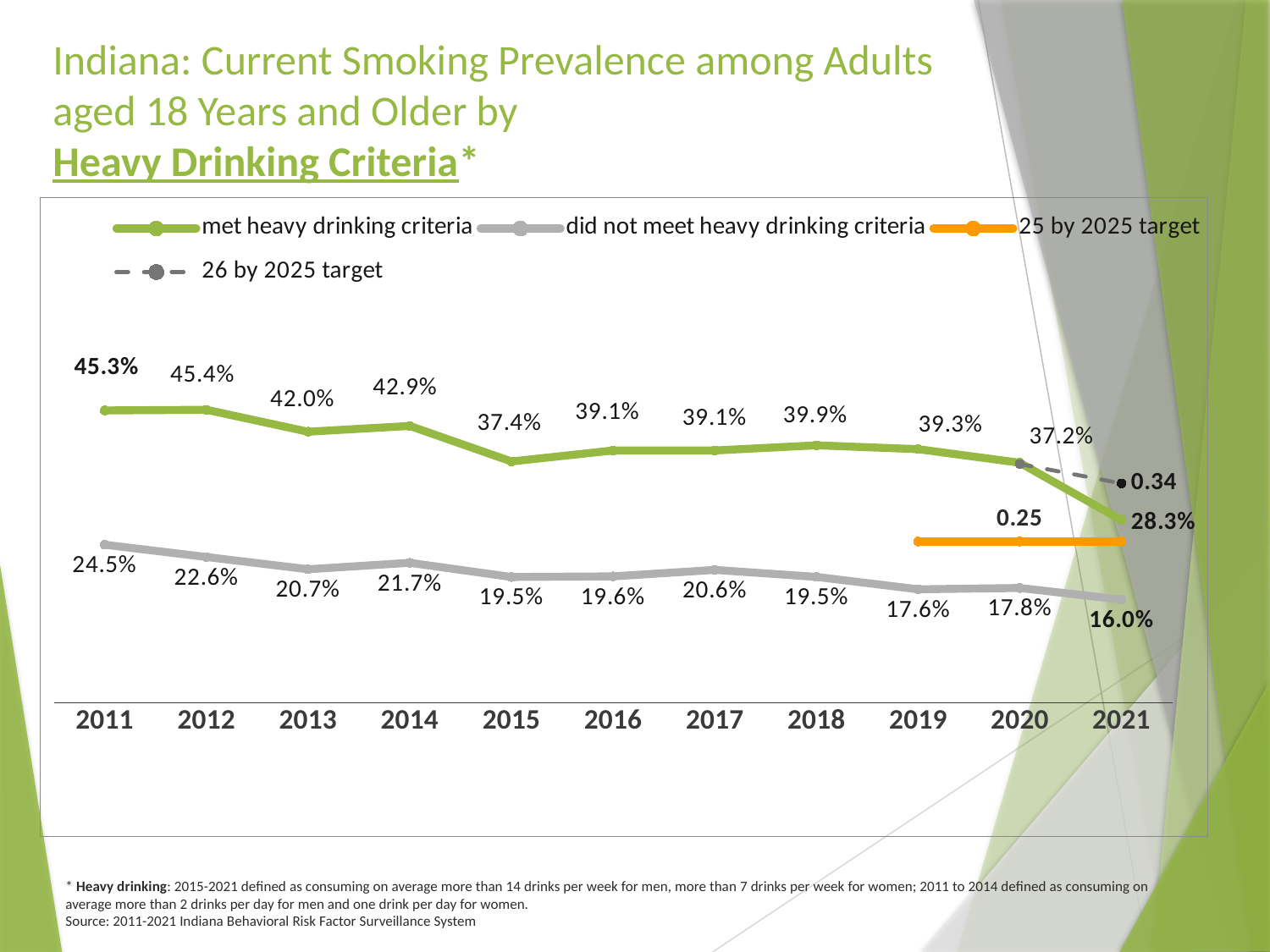
How many years are shown on the x axis? 11 What is the value for the 'met heavy drinking criteria' series in 2011? 45.3% What is the value for the 'did not meet heavy drinking criteria' series in 2021? 16.0% In which year is the 'met heavy drinking criteria' series at its lowest? 2021 How many series does the legend list? 4 In which year is the 'did not meet heavy drinking criteria' series at its highest? 2011 What is the difference between the 'met heavy drinking criteria' and 'did not meet heavy drinking criteria' values in 2021? 12.3 percentage points What is the value for the 'met heavy drinking criteria' series in 2015? 37.4% Does the 'met heavy drinking criteria' series rise or fall overall from 2011 to 2021? fall Which series has the larger value in 2018, 'met heavy drinking criteria' or 'did not meet heavy drinking criteria'? met heavy drinking criteria What is the value for the 'did not meet heavy drinking criteria' series in 2019? 17.6% What kind of chart is shown on the slide? line chart